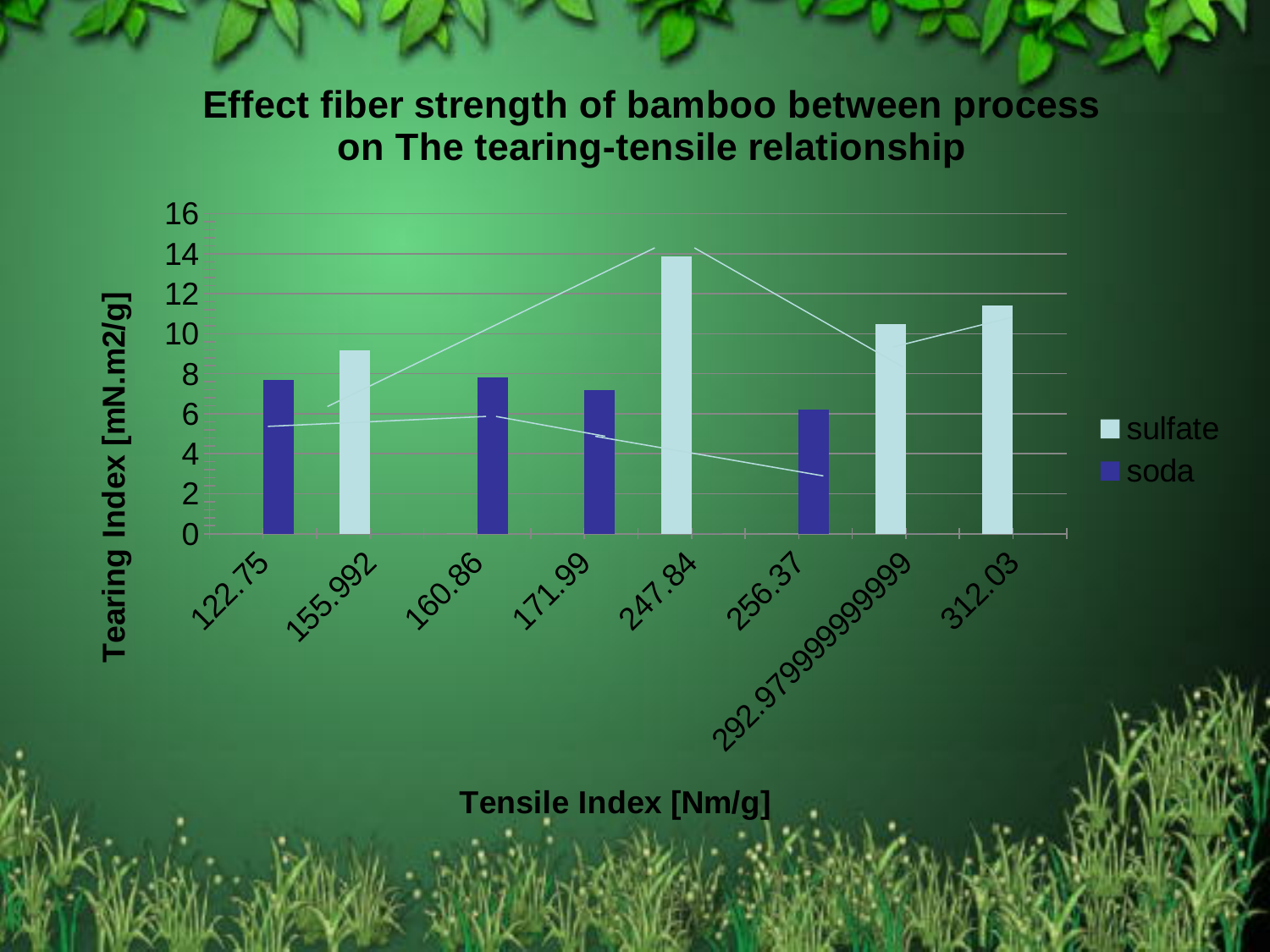
What is the label of the y axis? Tearing Index [mN.m2/g] How many series does the legend list? 2 How many tensile index categories are shown on the x axis? 8 Which tensile index category has the highest tearing index bar? 247.84 Is the tearing index for the 312.03 category greater or less than 10? greater Which tensile index category has the lowest tearing index bar? 256.37 Which series does the bar at tensile index 247.84 belong to? sulfate Is the tearing index for the 171.99 category greater or less than 8? less Which has the larger tearing index, the 155.992 category or the 256.37 category? 155.992 Is the tearing index for the 247.84 category greater or less than 12? greater What kind of chart is shown on the slide? bar chart